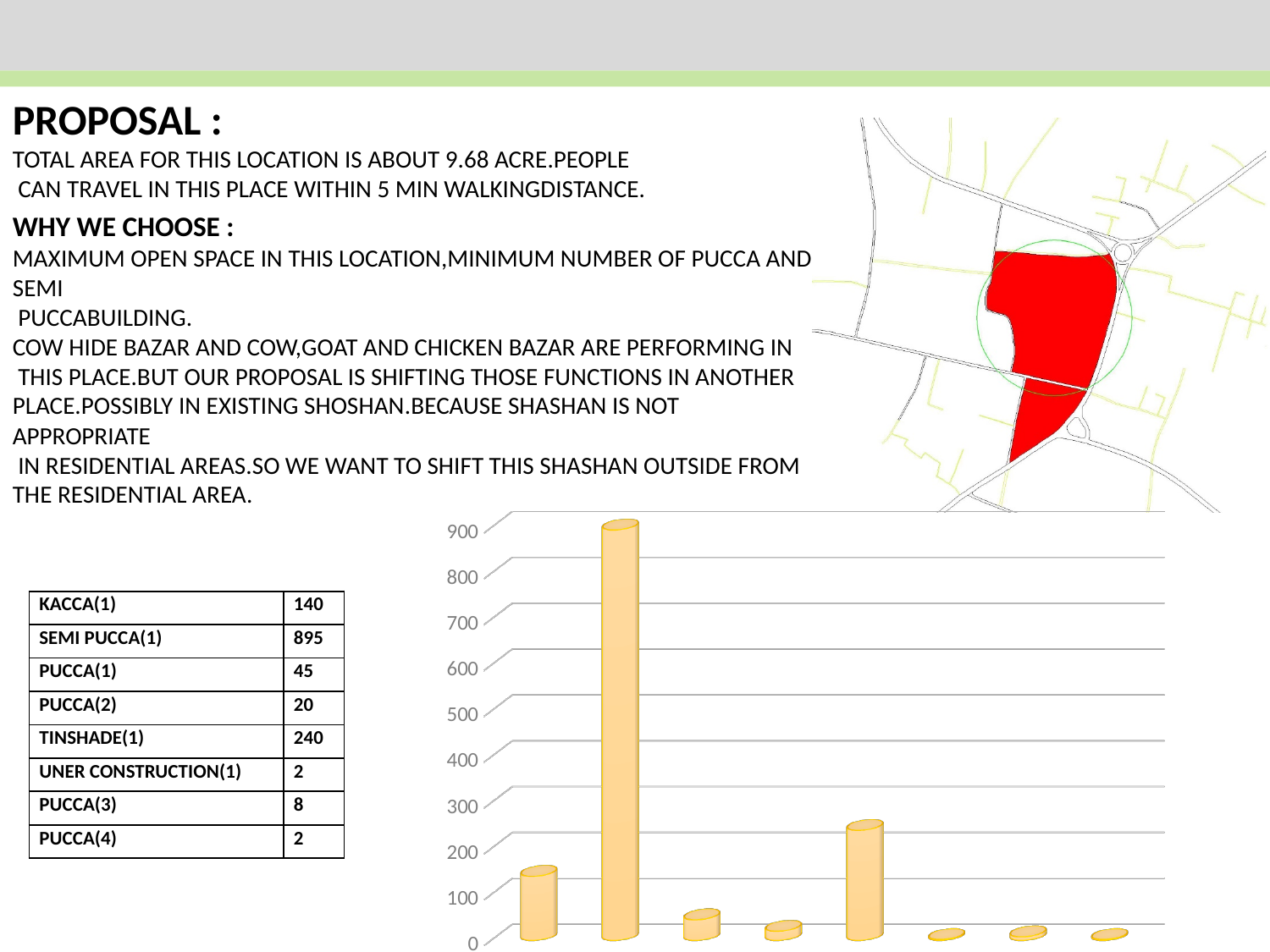
Is the value of the first bar from the left greater or less than 100? greater Is the value of the first bar from the left greater or less than 200? less Is the value of the fifth bar from the left greater or less than 200? greater Which is taller in the chart, the first bar or the fifth bar from the left? the fifth bar What is the highest value labelled on the chart's vertical axis? 900 How many bars are plotted in the chart? 8 Which is taller in the chart, the third bar or the fourth bar from the left? the third bar What kind of chart is shown at the bottom right of the slide? bar chart Which bar in the chart is the tallest, counting from the left? the second bar